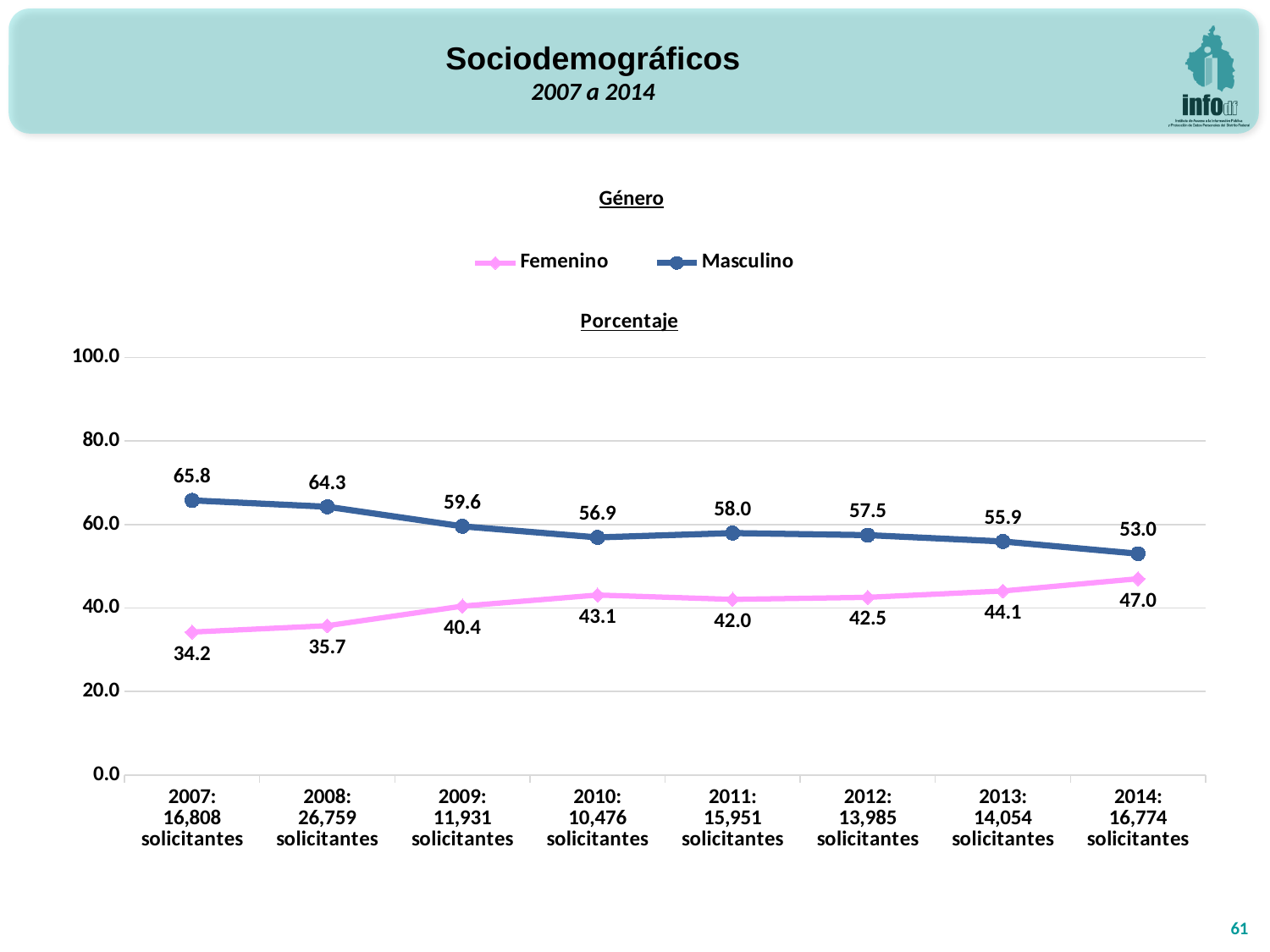
What is the Masculino value for 2007? 65.8 What kind of chart is shown? line chart Does the Masculino series generally rise or fall from 2007 to 2014? fall What is the Femenino value for 2011? 42.0 What is the Femenino value for 2014? 47.0 In which year is the Masculino value lowest? 2014 How many years are shown on the x axis? 8 Which is larger in 2014, the Masculino value or the Femenino value? Masculino What is the difference between the Masculino and Femenino values in 2007? 31.6 In which year is the Femenino value highest? 2014 How many series does the legend list? 2 Is the Femenino value for 2009 greater or less than 60.0? less